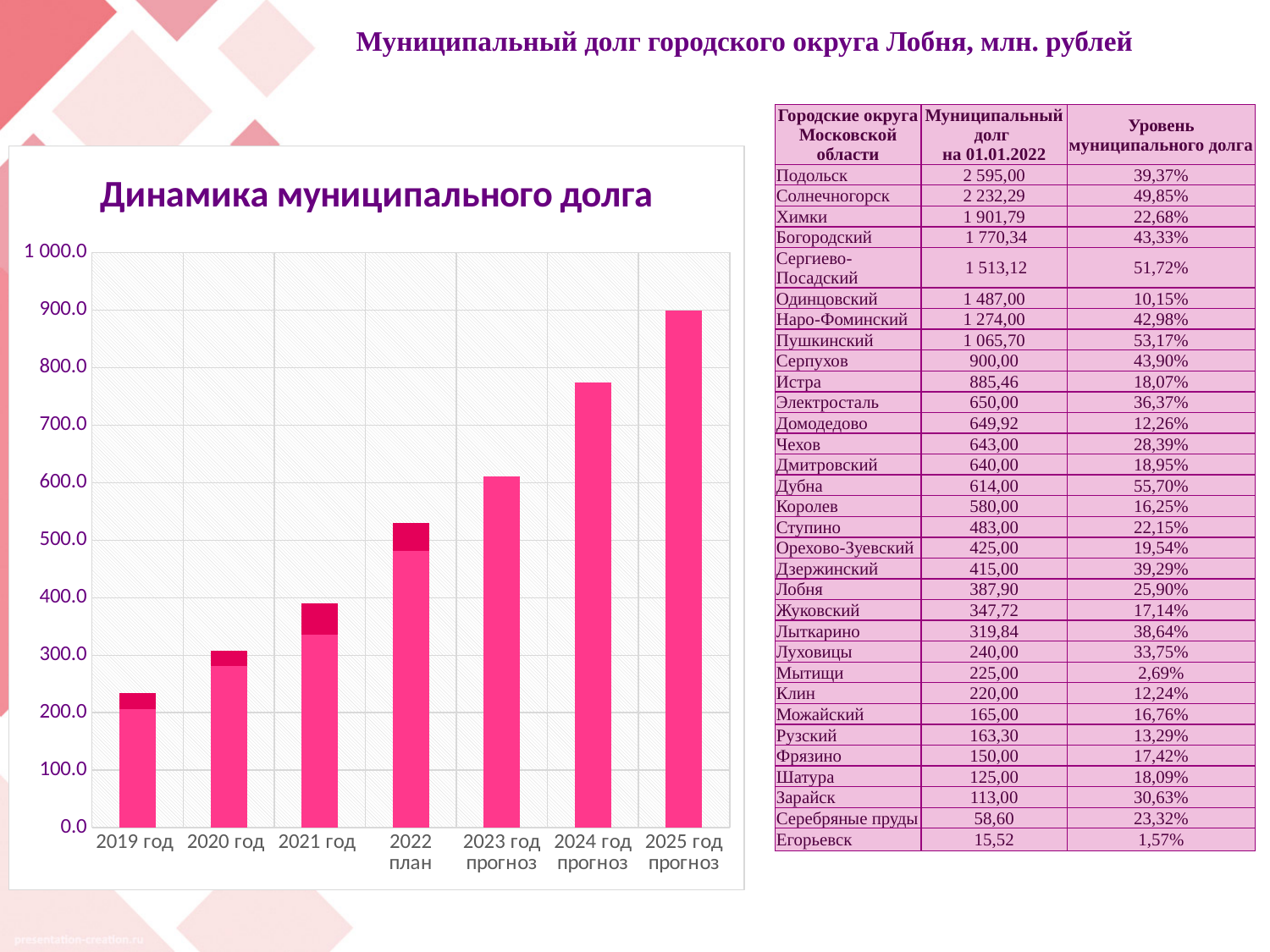
Which is larger in the chart: the bar for 2024 год прогноз or the bar for 2023 год прогноз? 2024 год прогноз Which category has the lowest total bar in the chart? 2019 год Which category has the highest total bar in the chart? 2025 год прогноз What is the title of the chart on the slide? Динамика муниципального долга Is the total bar for 2023 год прогноз greater or less than 700.0? less Is the total bar for 2019 год greater or less than 300.0? less How many categories (years) are shown on the x axis of the chart? 7 Is the total bar for 2020 год greater or less than 400.0? less What kind of chart is shown on the slide? bar chart Do the bar values rise or fall from 2019 год to 2025 год прогноз? rise